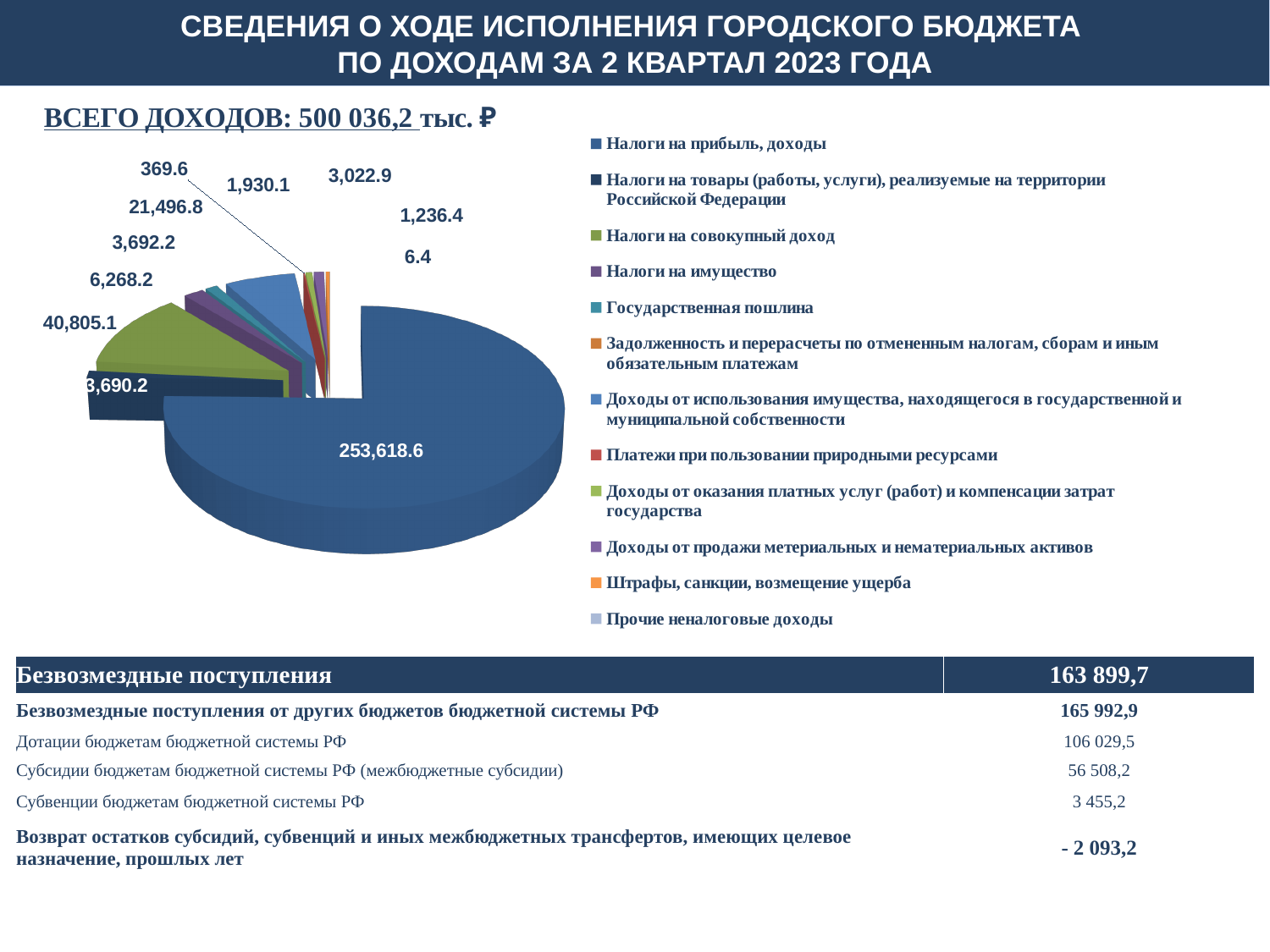
Which legend category does the largest slice of the pie chart belong to? Налоги на прибыль, доходы What is the value labelled on the purple slice (Налоги на имущество)? 6,268.2 What is the value of the largest slice in the pie chart? 253,618.6 What is the difference between the slices labelled 6,268.2 and 3,692.2? 2,576.0 What is the last entry listed in the chart legend? Прочие неналоговые доходы Which is larger, the slice labelled 40,805.1 or the slice labelled 21,496.8? 40,805.1 What total income figure is stated in the heading above the chart? 500 036,2 тыс. ₽ What is the difference between the largest slice (253,618.6) and the slice labelled 40,805.1? 212,813.5 How many entries does the chart legend list? 12 What kind of chart is shown on the slide? pie chart What is the value labelled on the green slice (Налоги на совокупный доход)? 40,805.1 What is the smallest value labelled on the pie chart? 6.4